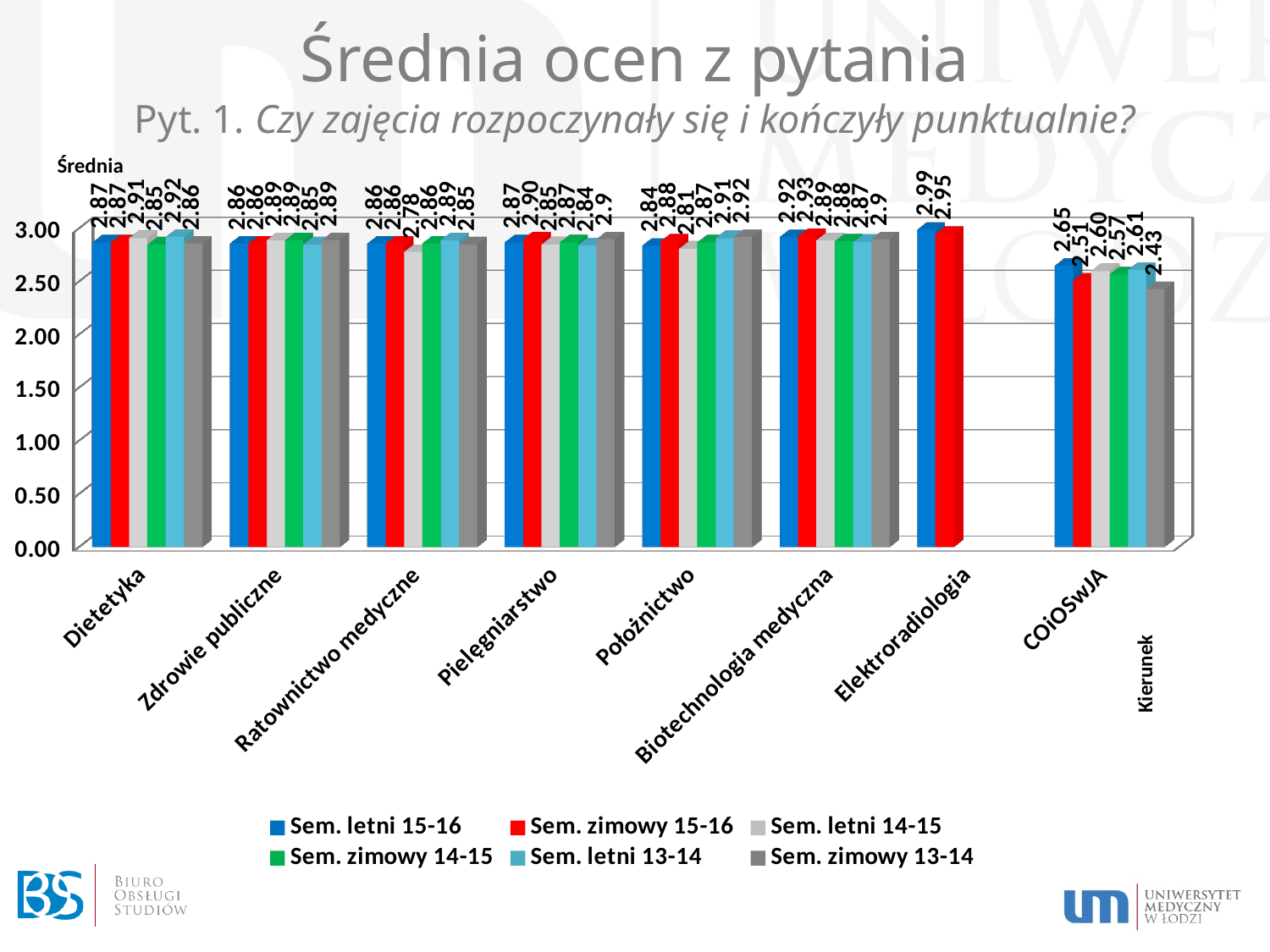
Which category has the lowest value in the Sem. letni 15-16 series? COiOSwJA Is the value for COiOSwJA in the Sem. zimowy 13-14 series greater or less than 2.50? less What is the value for Ratownictwo medyczne in the Sem. letni 14-15 series? 2.78 What kind of chart is shown on the slide? bar chart What is the value for Biotechnologia medyczna in the Sem. zimowy 15-16 series? 2.93 Which category has the highest value in the Sem. zimowy 15-16 series? Elektroradiologia What is the value for Elektroradiologia in the Sem. letni 15-16 series? 2.99 How many series does the legend list? 6 How many categories (kierunki) are shown on the x axis? 8 Which is larger for COiOSwJA: the Sem. letni 15-16 value or the Sem. zimowy 15-16 value? Sem. letni 15-16 What is the difference between the Sem. letni 15-16 values for Elektroradiologia and COiOSwJA? 0.34 What is the value for COiOSwJA in the Sem. zimowy 13-14 series? 2.43